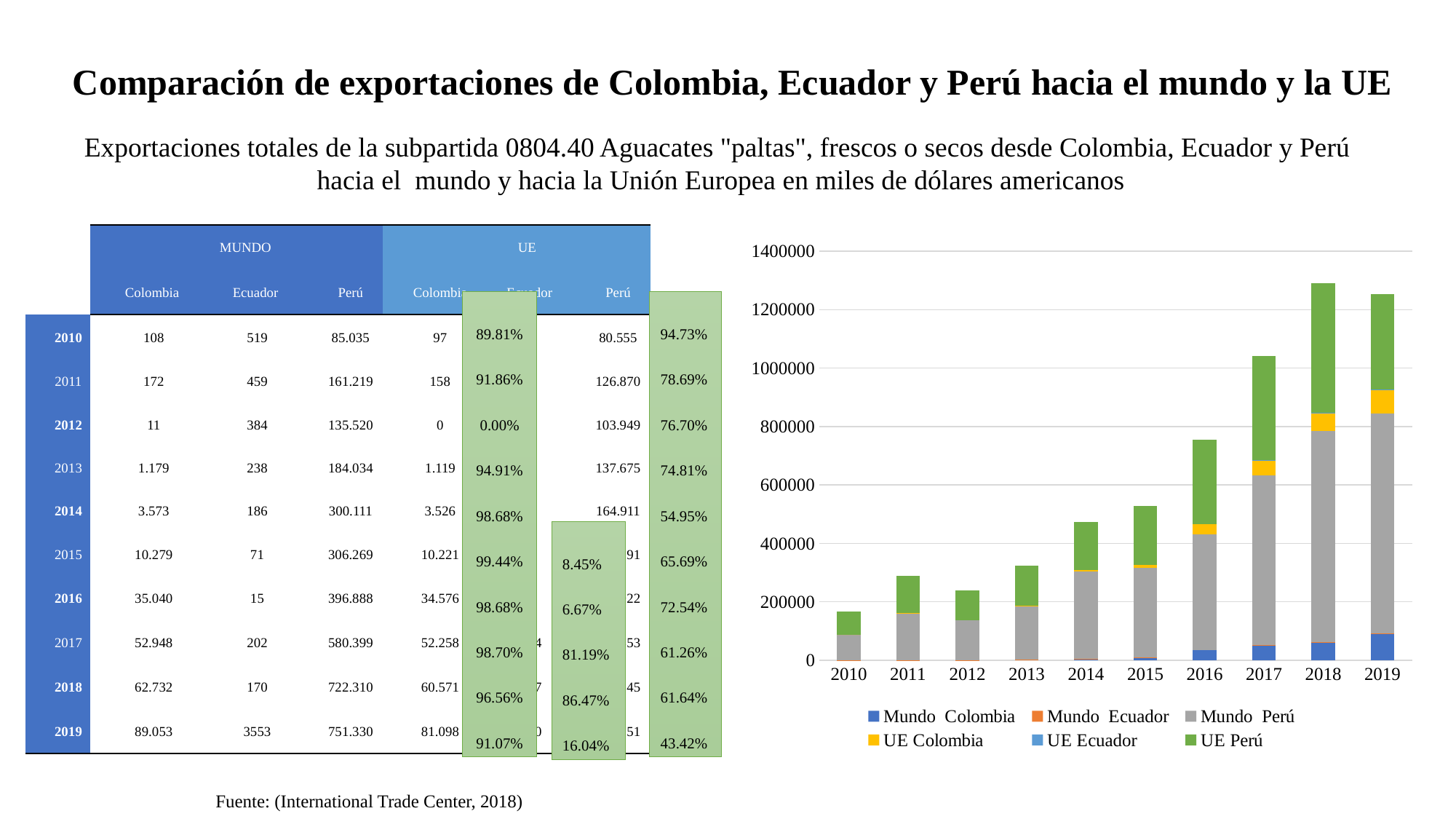
In the bar chart, is the total stacked value for 2016 greater or less than 800000? less What kind of chart is shown on the right side of the slide? stacked bar chart In the bar chart, is the total stacked value for 2010 greater or less than 200000? less How many series does the legend of the bar chart list? 6 In the bar chart, which year has the taller stacked bar, 2011 or 2012? 2011 In the bar chart, is the total stacked value for 2019 greater or less than 1200000? greater In the bar chart, which year has the tallest stacked bar? 2018 In the bar chart legend, which colour represents the series Mundo Perú? gray How many years are shown on the x axis of the bar chart? 10 In the bar chart, which year has the shortest stacked bar? 2010 In the bar chart, do the stacked bar totals generally rise or fall from 2010 to 2019? rise